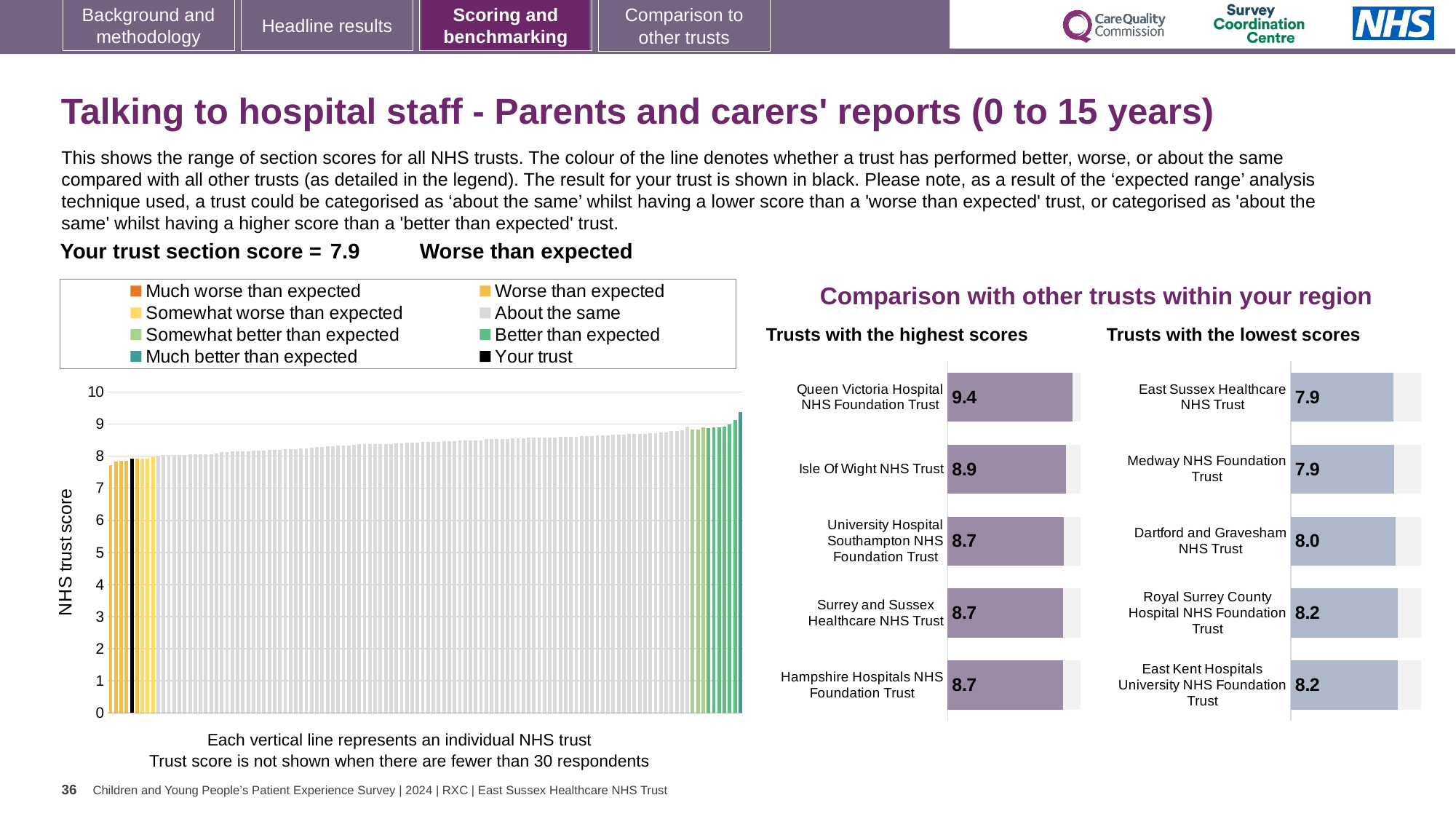
What kind of chart is the main 'NHS trust score' chart on the left? bar chart In the 'Trusts with the lowest scores' chart, what is the score for Dartford and Gravesham NHS Trust? 8.0 In the main 'NHS trust score' chart, do the values rise or fall from left to right? rise In the 'Trusts with the highest scores' chart, which trust has the highest score? Queen Victoria Hospital NHS Foundation Trust How many entries does the legend of the main NHS trust score chart list? 8 Which has the larger score: Isle Of Wight NHS Trust in the highest scores chart or Dartford and Gravesham NHS Trust in the lowest scores chart? Isle Of Wight NHS Trust In the 'Trusts with the lowest scores' chart, what is the difference between the scores of Royal Surrey County Hospital NHS Foundation Trust and East Sussex Healthcare NHS Trust? 0.3 What is the title of the section containing the two small bar charts on the right of the slide? Comparison with other trusts within your region How many trusts are shown in the 'Trusts with the highest scores' chart? 5 In the 'Trusts with the highest scores' chart, what is the score for Queen Victoria Hospital NHS Foundation Trust? 9.4 In the 'Trusts with the highest scores' chart, what is the difference between the scores of Queen Victoria Hospital NHS Foundation Trust and Isle Of Wight NHS Trust? 0.5 In the main 'NHS trust score' chart, is the value for your trust (the black bar) greater or less than 5? greater